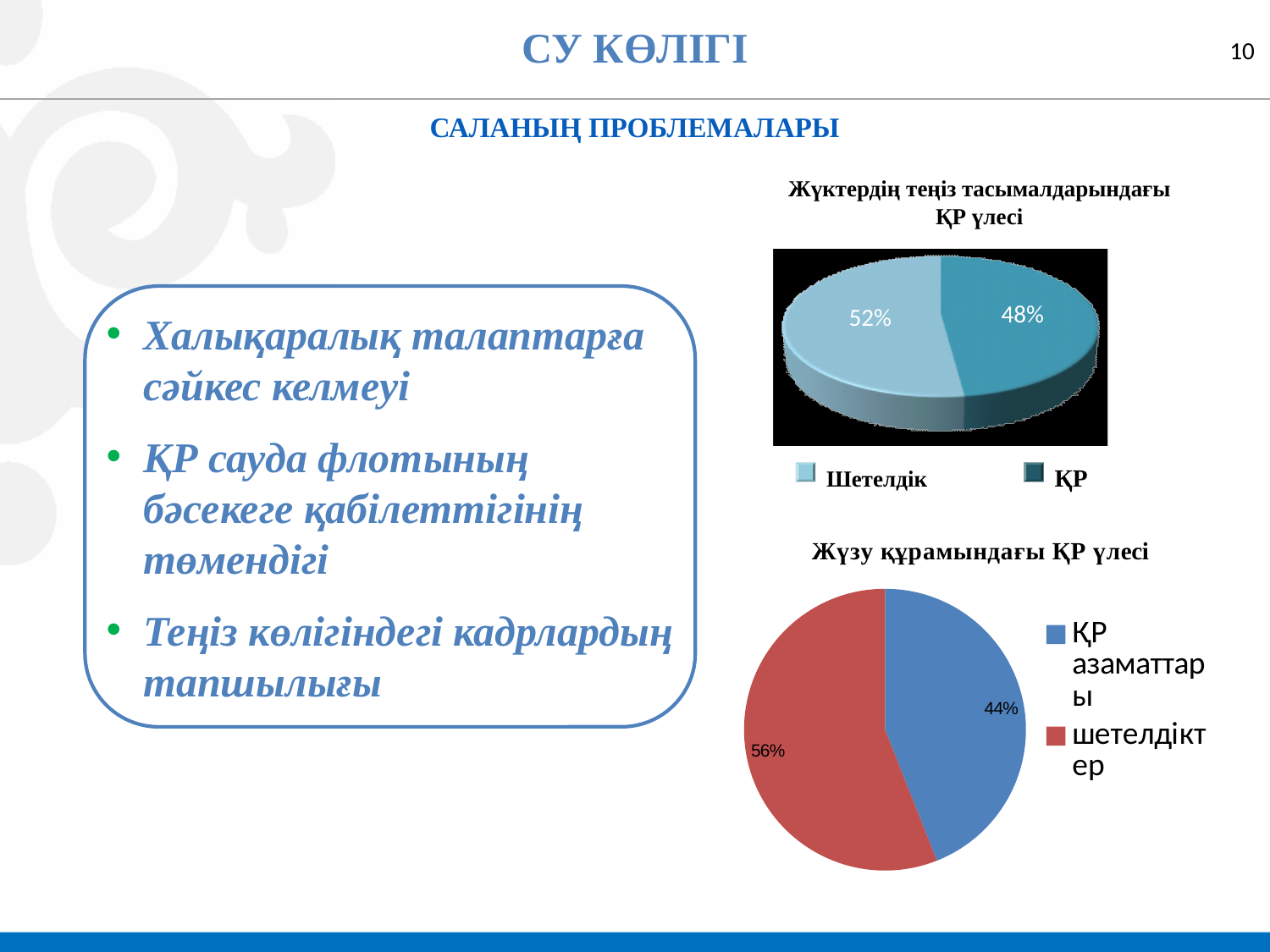
In the bottom chart 'Жүзу құрамындағы ҚР үлесі', what share is labelled for шетелдіктер? 56% In the top chart 'Жүктердің теңіз тасымалдарындағы ҚР үлесі', what is the difference between the Шетелдік and ҚР shares? 4% How many entries does the legend of the top chart 'Жүктердің теңіз тасымалдарындағы ҚР үлесі' list? 2 How many slices does the bottom chart 'Жүзу құрамындағы ҚР үлесі' have? 2 In the top chart 'Жүктердің теңіз тасымалдарындағы ҚР үлесі', what share is labelled for ҚР? 48% In the top chart 'Жүктердің теңіз тасымалдарындағы ҚР үлесі', what share is labelled for Шетелдік? 52% In the top chart 'Жүктердің теңіз тасымалдарындағы ҚР үлесі', which slice is larger, Шетелдік or ҚР? Шетелдік What kind of chart is the top chart 'Жүктердің теңіз тасымалдарындағы ҚР үлесі'? Pie chart In the bottom chart 'Жүзу құрамындағы ҚР үлесі', what share is labelled for ҚР азаматтары? 44% In the bottom chart 'Жүзу құрамындағы ҚР үлесі', what is the difference between the шетелдіктер and ҚР азаматтары shares? 12% In the bottom chart 'Жүзу құрамындағы ҚР үлесі', which slice is the largest? шетелдіктер In the bottom chart 'Жүзу құрамындағы ҚР үлесі', what colour is the шетелдіктер slice? Red